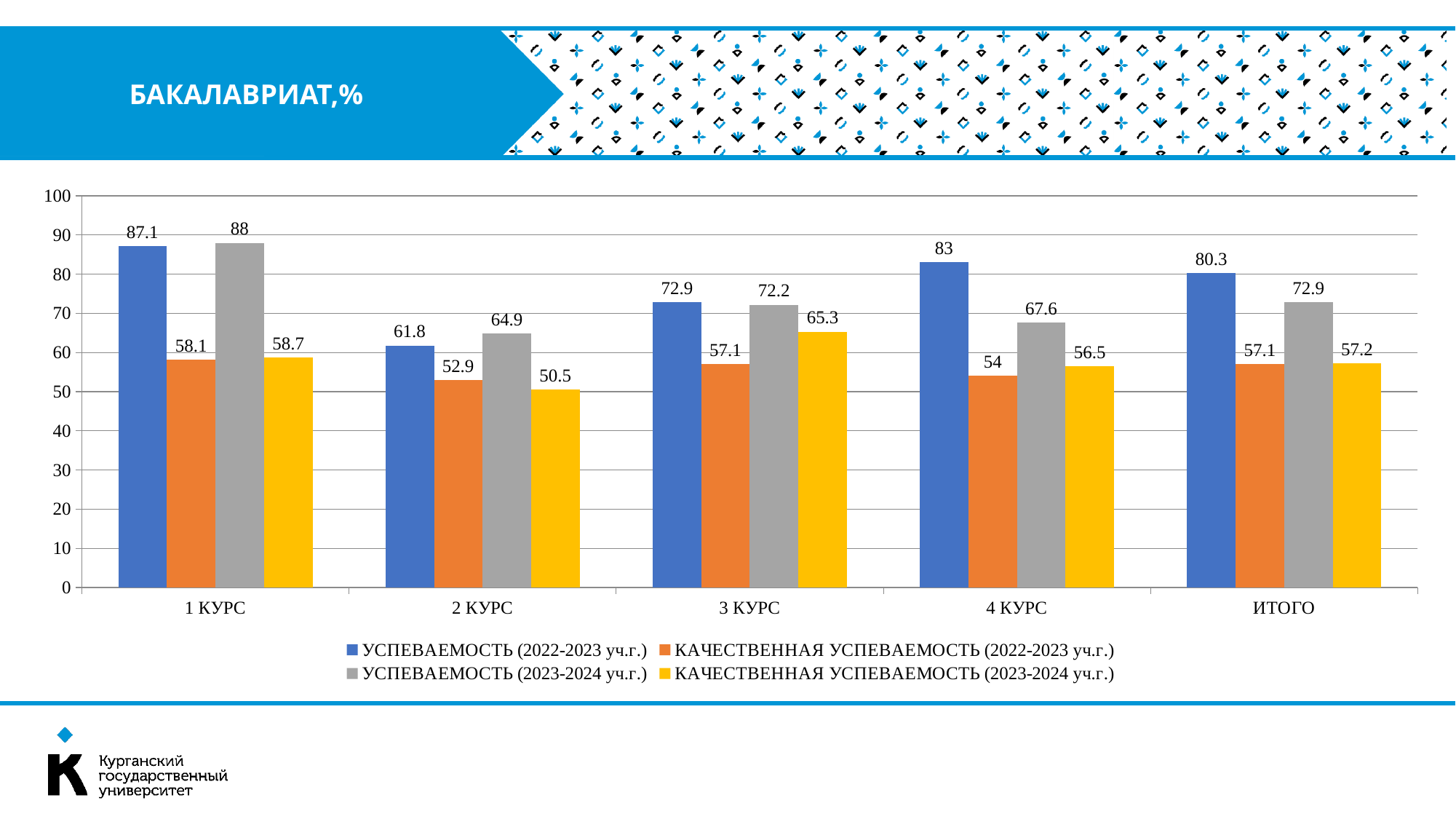
Which is larger for 2 КУРС: УСПЕВАЕМОСТЬ (2022-2023 уч.г.) or УСПЕВАЕМОСТЬ (2023-2024 уч.г.)? УСПЕВАЕМОСТЬ (2023-2024 уч.г.) Which category has the lowest value for КАЧЕСТВЕННАЯ УСПЕВАЕМОСТЬ (2023-2024 уч.г.)? 2 КУРС Is the value of КАЧЕСТВЕННАЯ УСПЕВАЕМОСТЬ (2022-2023 уч.г.) for 4 КУРС greater or less than 60? less What is the value of УСПЕВАЕМОСТЬ (2022-2023 уч.г.) for 1 КУРС? 87.1 Which category has the highest value for УСПЕВАЕМОСТЬ (2023-2024 уч.г.)? 1 КУРС What is the value of УСПЕВАЕМОСТЬ (2023-2024 уч.г.) for ИТОГО? 72.9 How many series does the legend list? 4 How many categories are shown on the x axis? 5 What kind of chart is shown on the slide? bar chart What is the title shown in the header of the slide? БАКАЛАВРИАТ,% What is the difference between УСПЕВАЕМОСТЬ (2022-2023 уч.г.) and УСПЕВАЕМОСТЬ (2023-2024 уч.г.) for 4 КУРС? 15.4 What is the value of КАЧЕСТВЕННАЯ УСПЕВАЕМОСТЬ (2023-2024 уч.г.) for 3 КУРС? 65.3